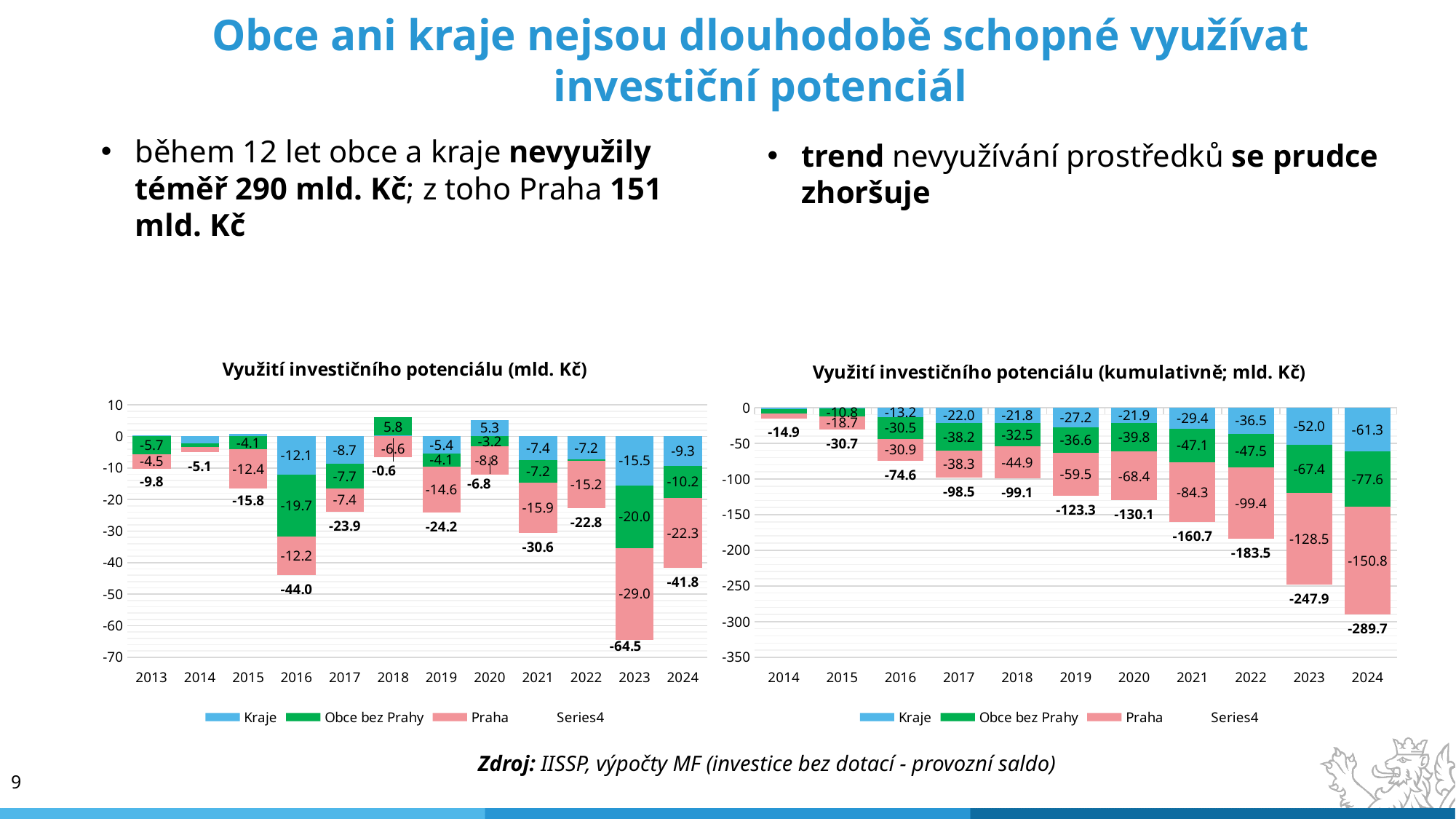
How many series does the legend of the right chart 'Využití investičního potenciálu (kumulativně; mld. Kč)' list? 4 In the right chart 'Využití investičního potenciálu (kumulativně; mld. Kč)', what is the value for Obce bez Prahy in 2021? -47.1 In the right chart 'Využití investičního potenciálu (kumulativně; mld. Kč)', which is more negative: the Praha value in 2022 or the Praha value in 2019? 2022 In the left chart 'Využití investičního potenciálu (mld. Kč)', what is the value for Praha in 2023? -29.0 In the left chart 'Využití investičního potenciálu (mld. Kč)', what is the total value shown for 2016? -44.0 In the left chart 'Využití investičního potenciálu (mld. Kč)', what is the value for Kraje in 2020? 5.3 In the left chart 'Využití investičního potenciálu (mld. Kč)', how many years are shown on the x axis? 12 In the left chart 'Využití investičního potenciálu (mld. Kč)', which year has the lowest (most negative) total value? 2023 In the right chart 'Využití investičního potenciálu (kumulativně; mld. Kč)', do the cumulative totals rise or fall from 2014 to 2024? fall What type of chart is the left chart 'Využití investičního potenciálu (mld. Kč)'? stacked bar chart In the right chart 'Využití investičního potenciálu (kumulativně; mld. Kč)', what is the cumulative total shown for 2024? -289.7 In the left chart 'Využití investičního potenciálu (mld. Kč)', what is the difference between the Praha value in 2023 (-29.0) and in 2024 (-22.3)? 6.7